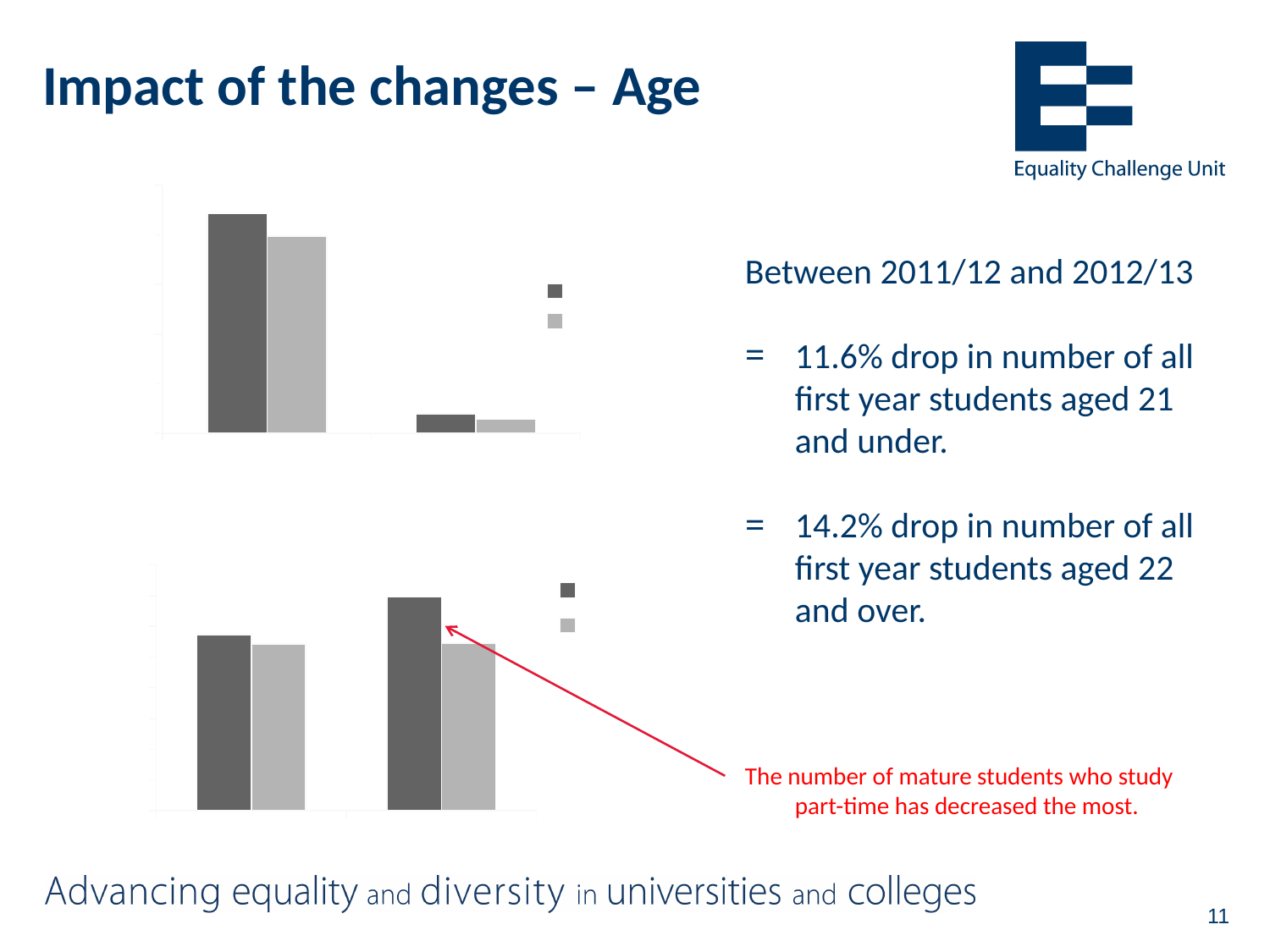
In the top chart, how many series does the legend show? 2 In the top chart, how many groups of bars are plotted? 2 In the bottom chart, how many groups of bars are plotted? 2 What kind of chart is the top chart on the slide? Bar chart In the bottom chart, within the right group, is the dark grey bar taller or shorter than the light grey bar? Taller In the bottom chart, how many series does the legend show? 2 What kind of chart is the bottom chart on the slide? Bar chart What two colours are used for the bars in the charts on the slide? Dark grey and light grey In the top chart, within the left group, is the dark grey bar taller or shorter than the light grey bar? Taller In the top chart, which group of bars is taller, the left group or the right group? The left group